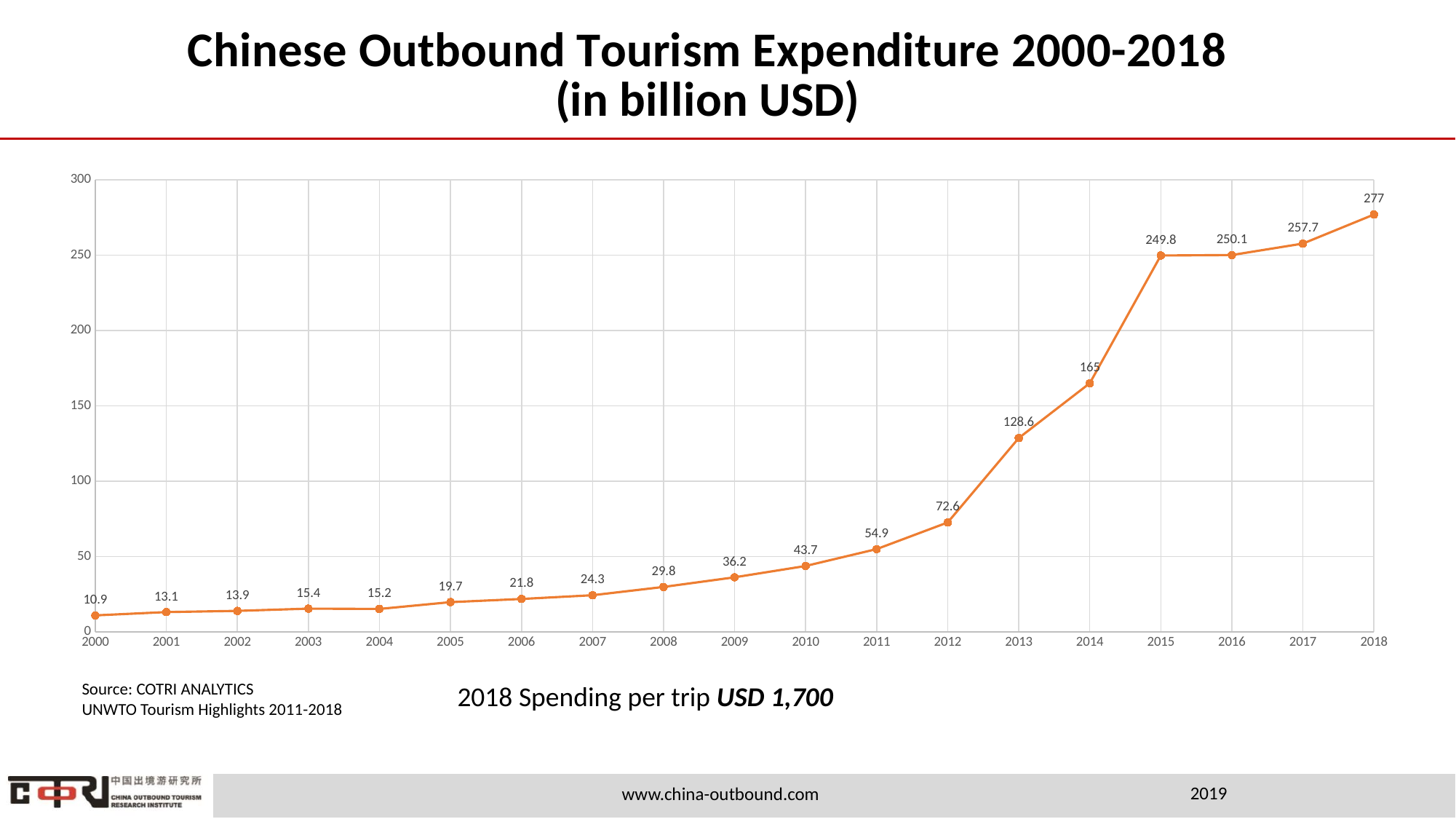
How many years are plotted on the chart? 19 What is the title of the chart? Chinese Outbound Tourism Expenditure 2000-2018 (in billion USD) What is the difference between the values for 2015 and 2014? 84.8 Do the values generally rise or fall from 2000 to 2018? Rise What kind of chart is shown on the slide? Line chart Which is larger, the value for 2012 or the value for 2011? 2012 Is the value for 2017 greater or less than 250? greater Which year has the highest expenditure? 2018 What is the value plotted for 2013? 128.6 What is the Chinese outbound tourism expenditure for 2018? 277 Which year has the lowest expenditure? 2000 What is the value plotted for 2000? 10.9